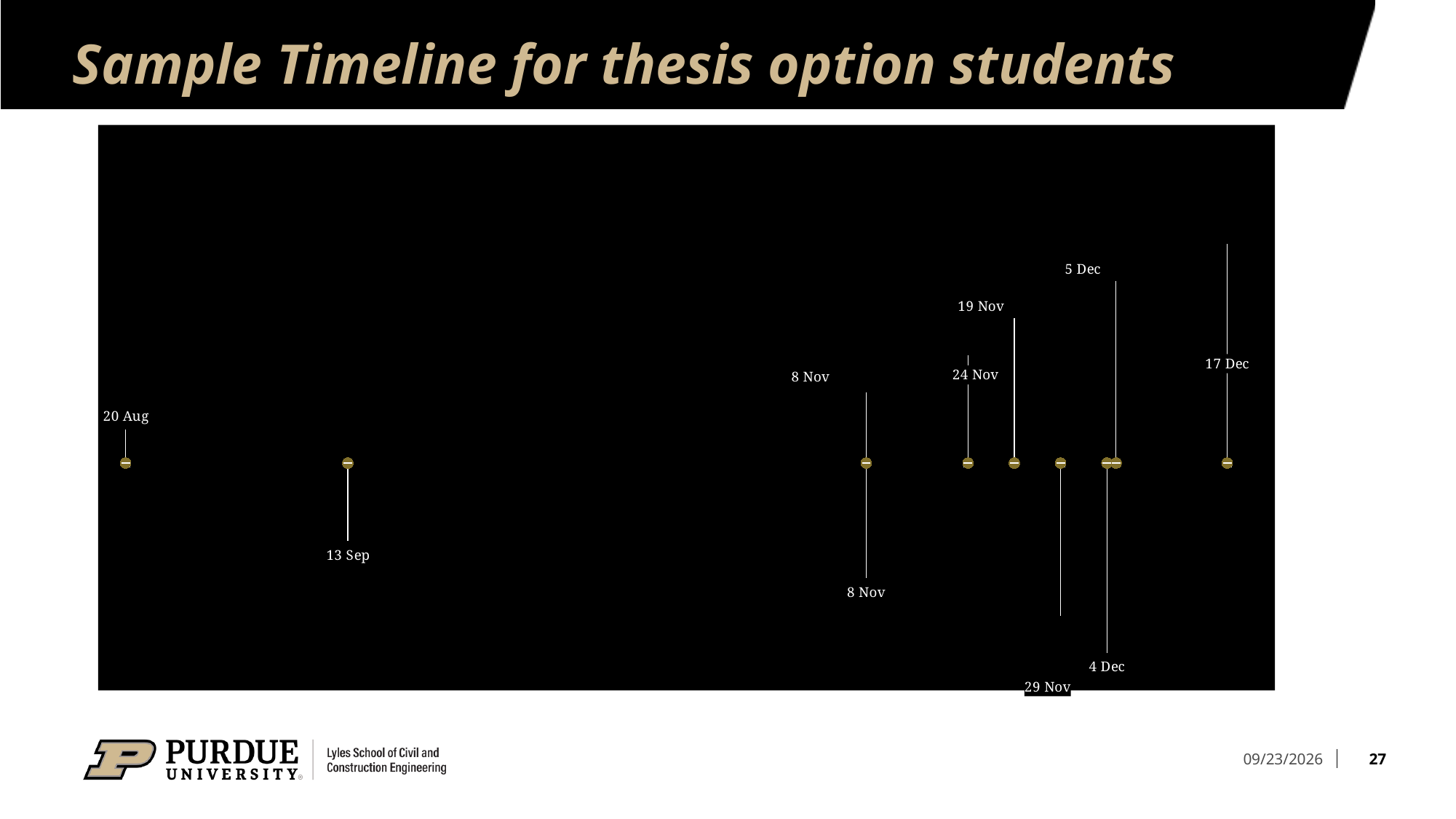
How many date labels are shown on the timeline? 10 What kind of chart is shown on the slide? Timeline chart Which date is later on the timeline, 4 Dec or 5 Dec? 5 Dec Which date label appears twice on the timeline? 8 Nov Which date label is placed at the very bottom edge of the chart? 29 Nov What is the earliest date labelled on the timeline? 20 Aug Which date comes first on the timeline, 13 Sep or 8 Nov? 13 Sep What is the latest date labelled on the timeline? 17 Dec How many date labels on the timeline fall in December? 3 What is the title of the slide containing the timeline? Sample Timeline for thesis option students What is the second date labelled on the timeline after 20 Aug? 13 Sep